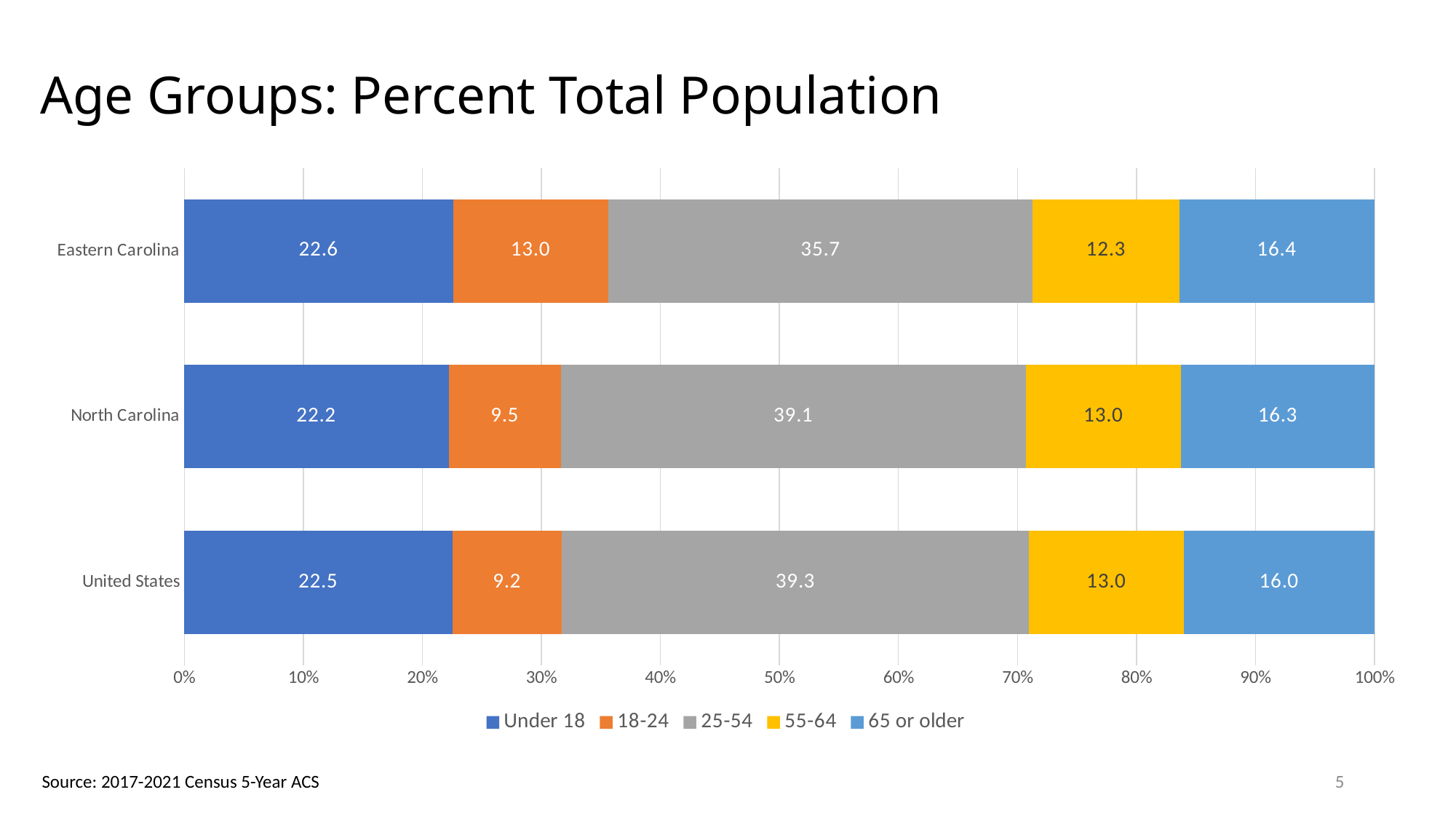
Which region has the lowest value for the 25-54 age group? Eastern Carolina What is the title of the chart? Age Groups: Percent Total Population How many regions are shown on the chart? 3 What kind of chart is shown on the slide? Stacked bar chart What is the value for the 65 or older age group in the United States? 16.0 Which region has the highest value for the 18-24 age group? Eastern Carolina How many age groups does the legend list? 5 What is the value for the 25-54 age group in Eastern Carolina? 35.7 What is the difference between the 18-24 values for Eastern Carolina and North Carolina? 3.5 What is the total of the stacked bar for the United States? 100.0 What is the value for the 18-24 age group in North Carolina? 9.5 Which is larger: the Under 18 value for Eastern Carolina or for North Carolina? Eastern Carolina